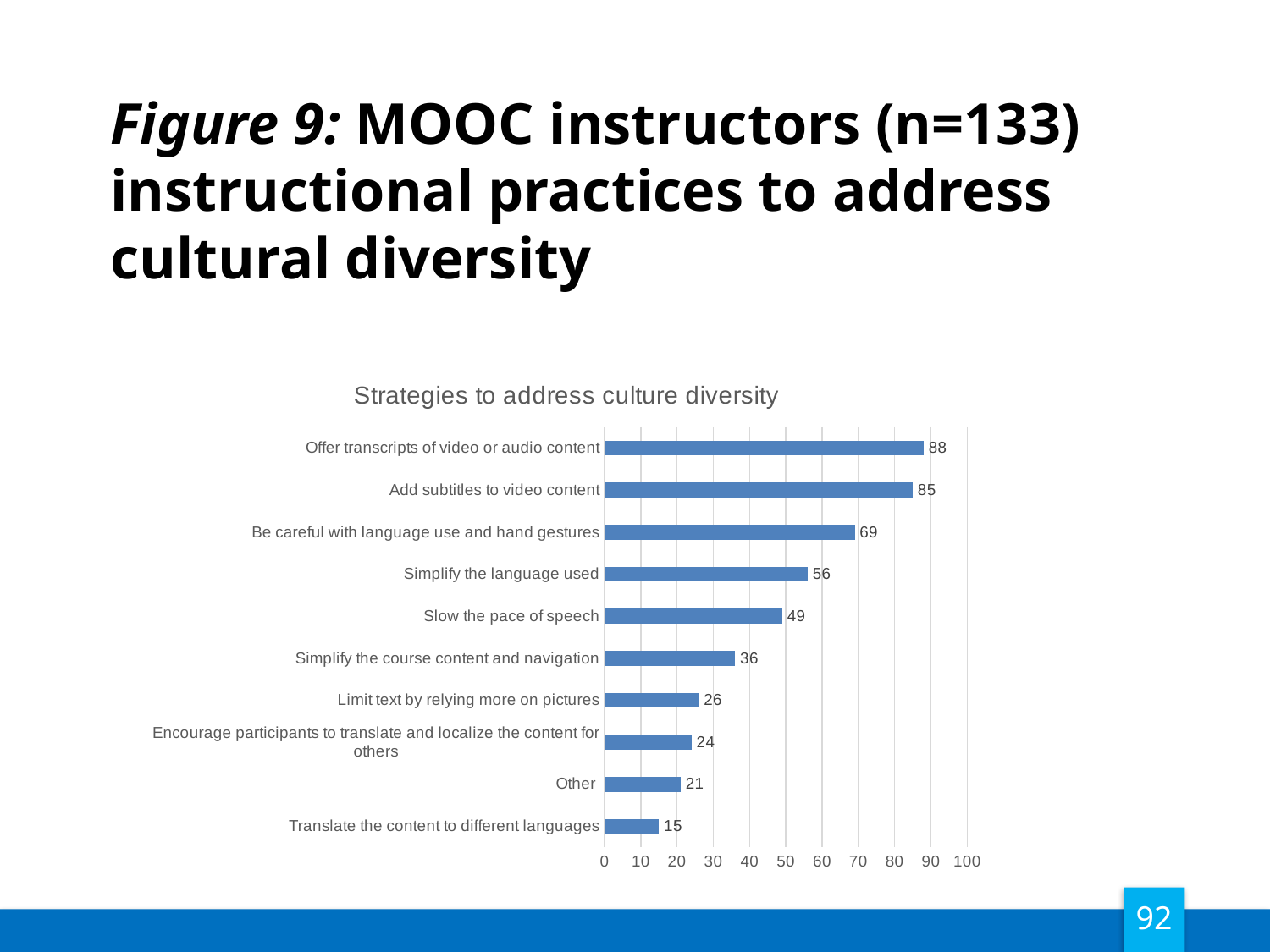
Which strategy has the lowest value? Translate the content to different languages What is the difference between the values for "Simplify the course content and navigation" and "Translate the content to different languages"? 21 Is the value for "Be careful with language use and hand gestures" greater or less than 60? greater What is the value for "Other"? 21 What is the value for "Offer transcripts of video or audio content"? 88 Which strategy has the highest value? Offer transcripts of video or audio content What is the difference between the values for "Add subtitles to video content" and "Simplify the language used"? 29 What kind of chart is shown on the slide? bar chart What is the value for "Slow the pace of speech"? 49 Which is larger: the value for "Limit text by relying more on pictures" or the value for "Encourage participants to translate and localize the content for others"? Limit text by relying more on pictures How many strategies are shown in the chart? 10 What is the title of the chart? Strategies to address culture diversity